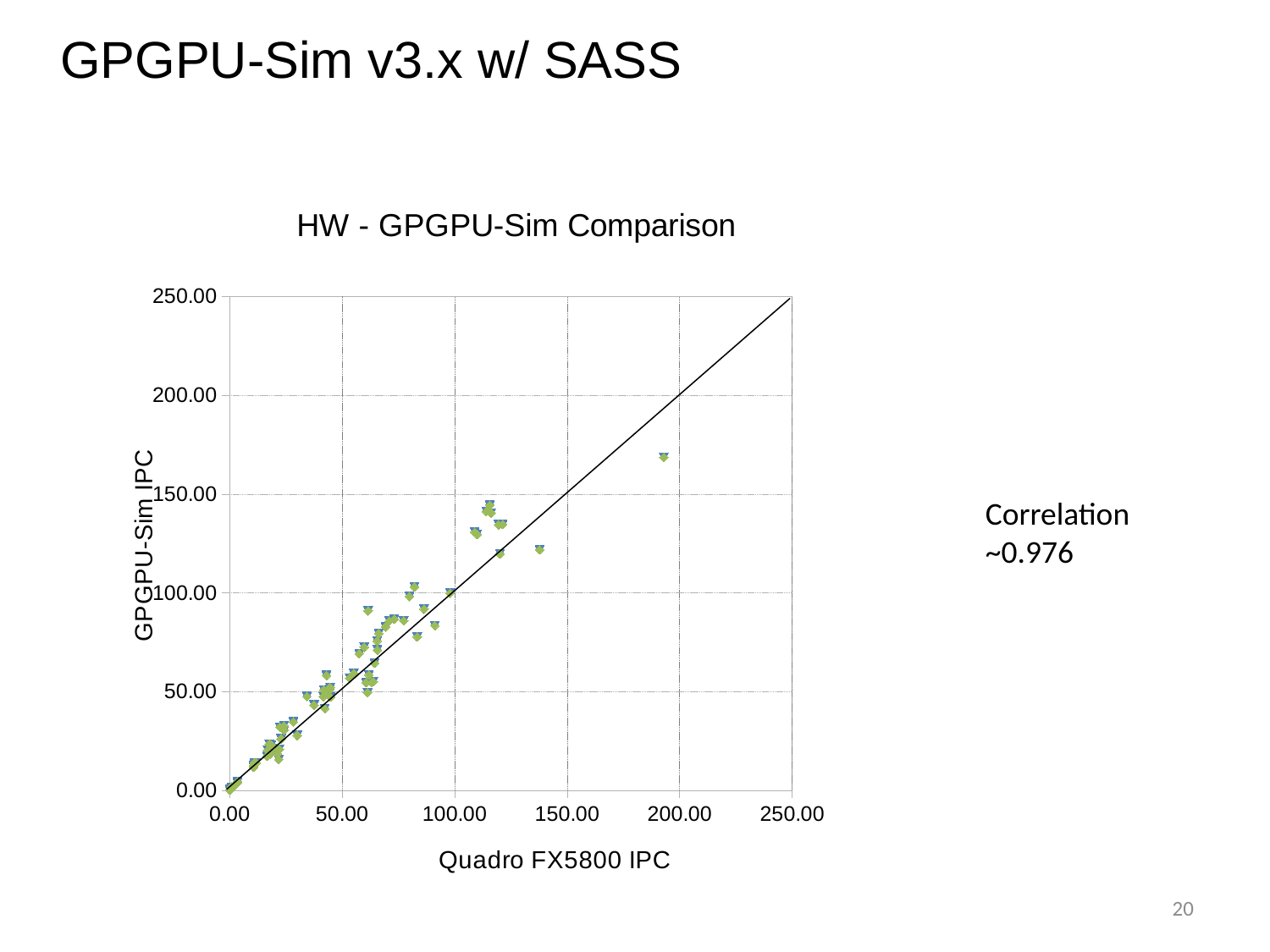
Is the Quadro FX5800 IPC value of the rightmost point greater or less than 150? greater Is the GPGPU-Sim IPC value of the rightmost point greater or less than 200? less What is the title of the chart? HW - GPGPU-Sim Comparison Is the Quadro FX5800 IPC value of the rightmost point greater or less than 200? less Do the GPGPU-Sim IPC values generally rise or fall as the Quadro FX5800 IPC increases? rise What is the label of the x axis of the chart? Quadro FX5800 IPC What kind of chart is shown on the slide? scatter chart